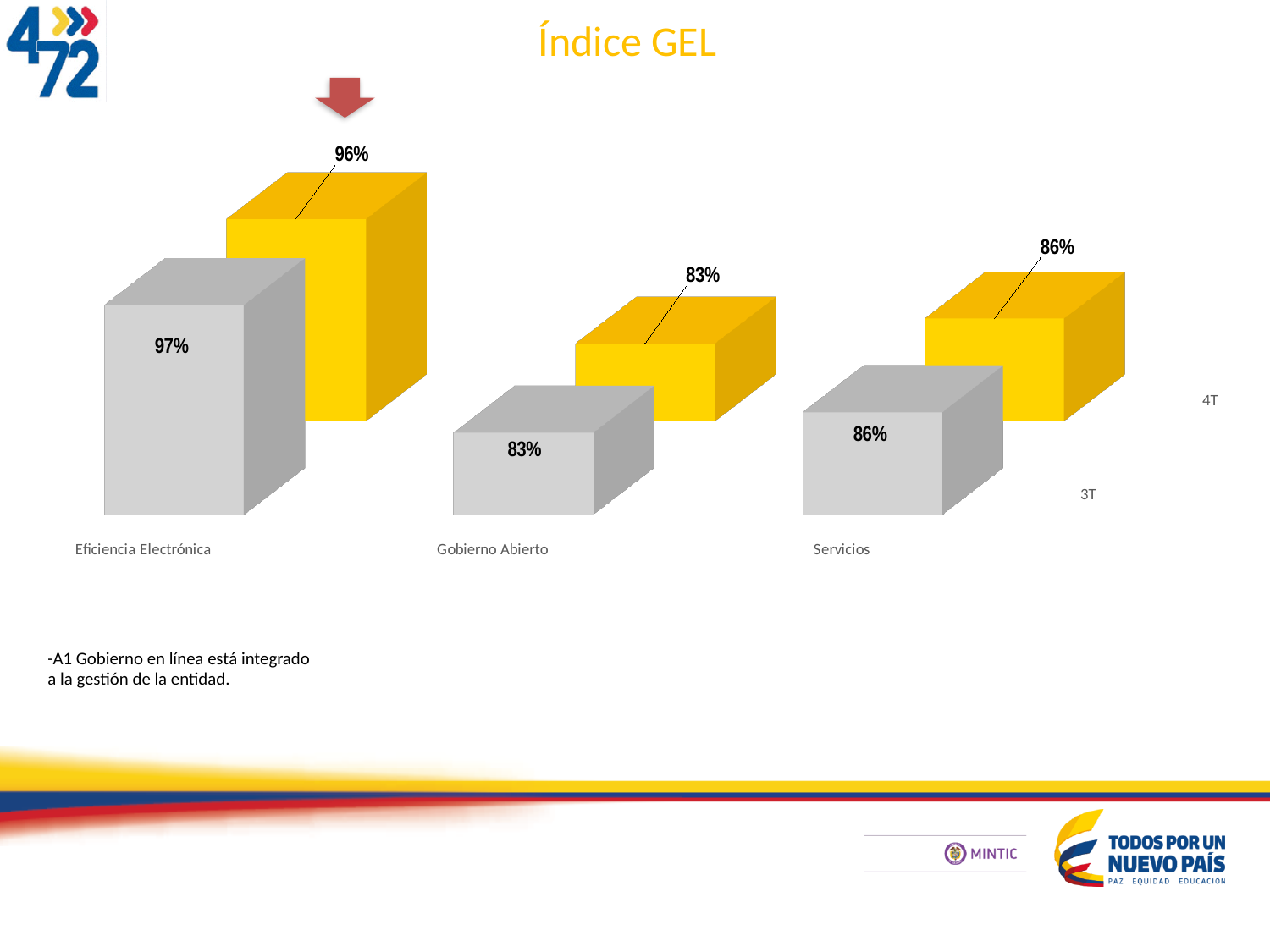
How many series does the chart show? 2 Which category has the highest value in the 4T series? Eficiencia Electrónica Which category has the lowest value in the 3T series? Gobierno Abierto What is the value for Eficiencia Electrónica in the 4T series? 96% What is the value for Gobierno Abierto in the 4T series? 83% What is the difference between the 4T values for Eficiencia Electrónica and Gobierno Abierto? 13% How many categories are shown on the x axis? 3 What is the title of the chart? Índice GEL What is the value for Servicios in the 3T series? 86% What is the value for Eficiencia Electrónica in the 3T series? 97% Which is larger: the 4T value for Servicios or the 4T value for Gobierno Abierto? Servicios What is the difference between the 3T and 4T values for Eficiencia Electrónica? 1%